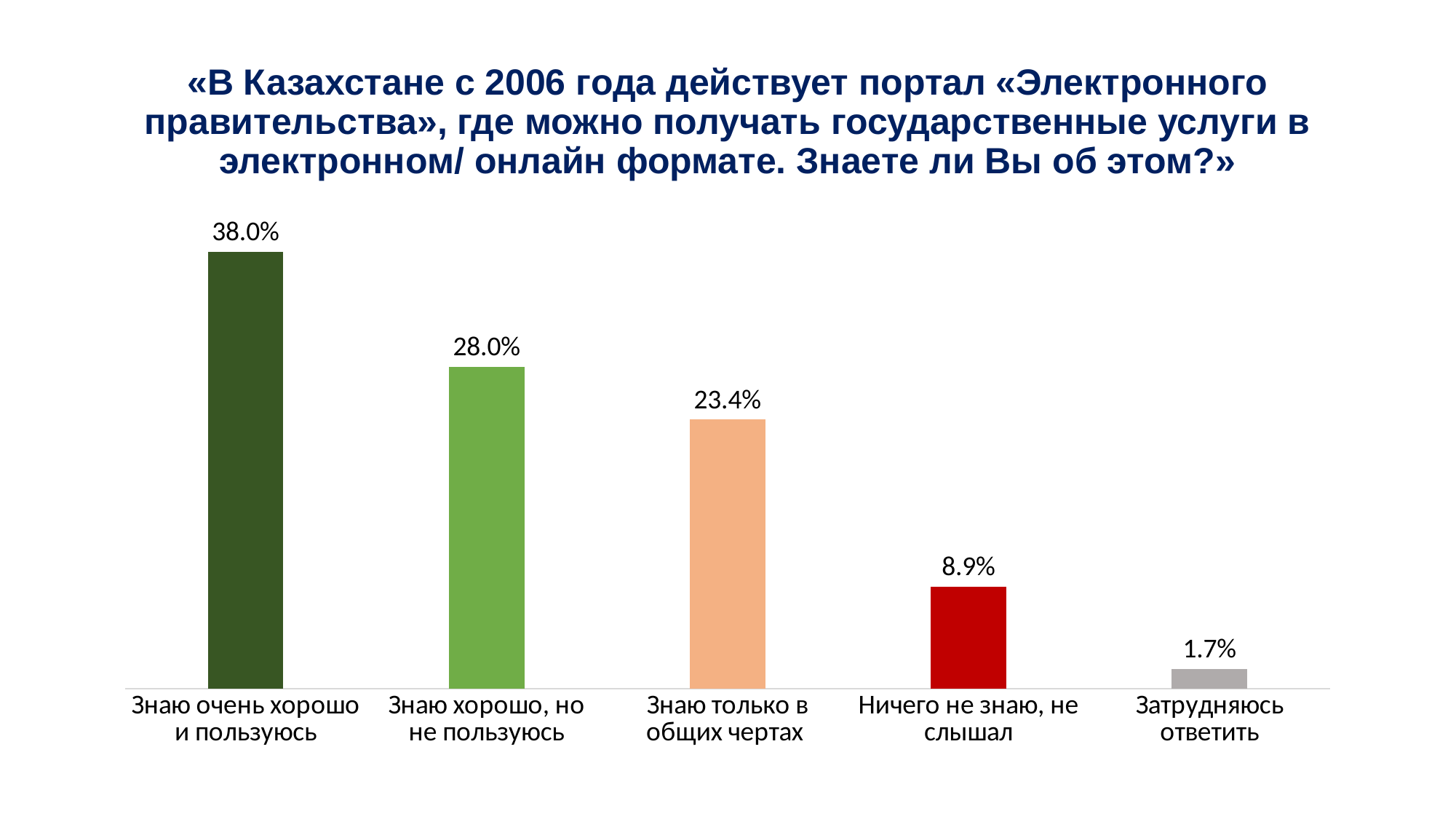
What is the value for "Ничего не знаю, не слышал"? 8.9% What is the difference between the values for "Знаю очень хорошо и пользуюсь" and "Знаю хорошо, но не пользуюсь"? 10.0% What kind of chart is shown on the slide? Bar chart Which category has the highest value? Знаю очень хорошо и пользуюсь What is the value for "Знаю очень хорошо и пользуюсь"? 38.0% What is the value for "Затрудняюсь ответить"? 1.7% Which is larger: the value for "Знаю хорошо, но не пользуюсь" or for "Знаю только в общих чертах"? Знаю хорошо, но не пользуюсь How many categories are shown in the chart? 5 What is the value for "Знаю хорошо, но не пользуюсь"? 28.0% What is the value for "Знаю только в общих чертах"? 23.4% Which category has the lowest value? Затрудняюсь ответить What is the difference between the values for "Знаю только в общих чертах" and "Ничего не знаю, не слышал"? 14.5%